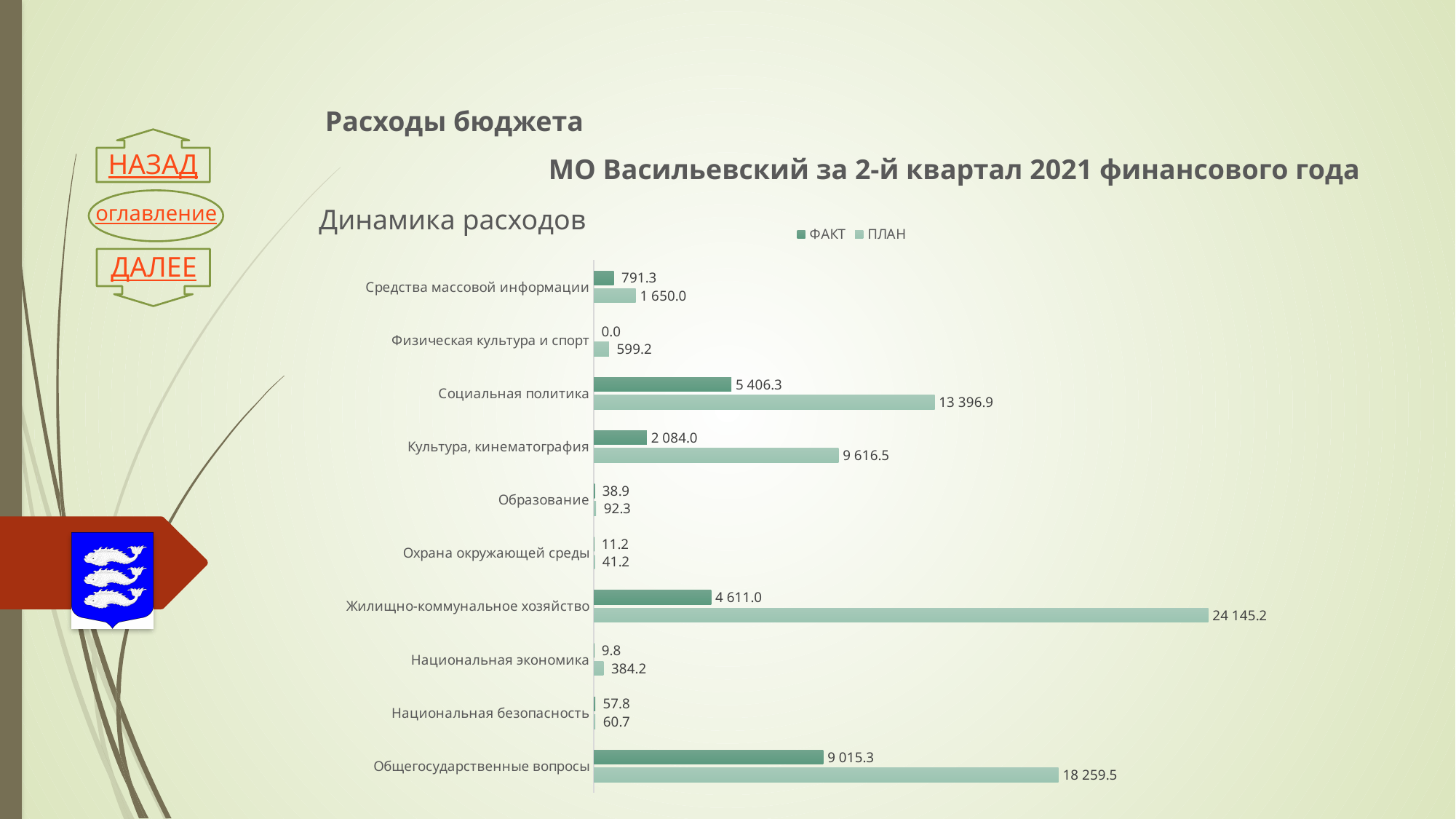
Which category has the lowest ПЛАН value? Охрана окружающей среды What are the two series named in the chart legend? ФАКТ and ПЛАН What is the ФАКТ value for Социальная политика? 5 406.3 What is the ПЛАН value for Жилищно-коммунальное хозяйство? 24 145.2 What is the difference between the ПЛАН and ФАКТ values for Общегосударственные вопросы? 9 244.2 How many categories are shown on the chart? 10 Which category has the highest ФАКТ value? Общегосударственные вопросы What type of chart is shown on the slide? bar chart How many series does the chart legend list? 2 Which is larger: the ФАКТ value for Культура, кинематография or the ФАКТ value for Жилищно-коммунальное хозяйство? Жилищно-коммунальное хозяйство Which category has the highest ПЛАН value? Жилищно-коммунальное хозяйство What is the ФАКТ value for Физическая культура и спорт? 0.0